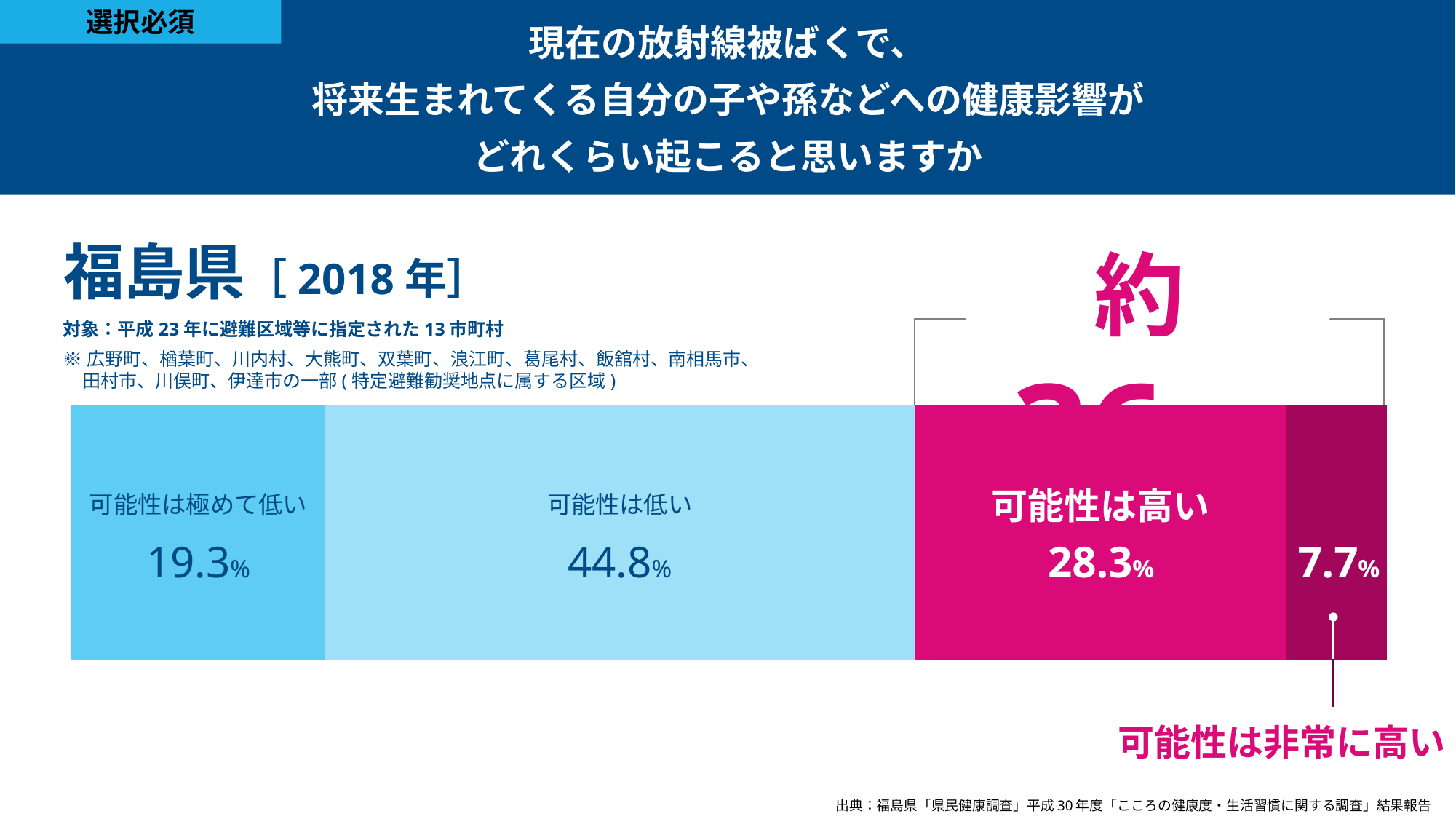
Which is larger, the share for 可能性は極めて低い or the share for 可能性は高い? 可能性は高い What percentage of respondents answered 可能性は低い? 44.8% How many response categories are shown in the bar? 4 What percentage of respondents answered 可能性は非常に高い? 7.7% What is the difference between the shares for 可能性は低い and 可能性は高い? 16.5% What percentage of respondents answered 可能性は極めて低い? 19.3% Which response category has the largest share? 可能性は低い What is the combined share of 可能性は高い and 可能性は非常に高い? 36.0% Which response category has the smallest share? 可能性は非常に高い What kind of chart is shown on the slide? Stacked bar chart Which year does the chart's data refer to? 2018年 What percentage of respondents answered 可能性は高い? 28.3%